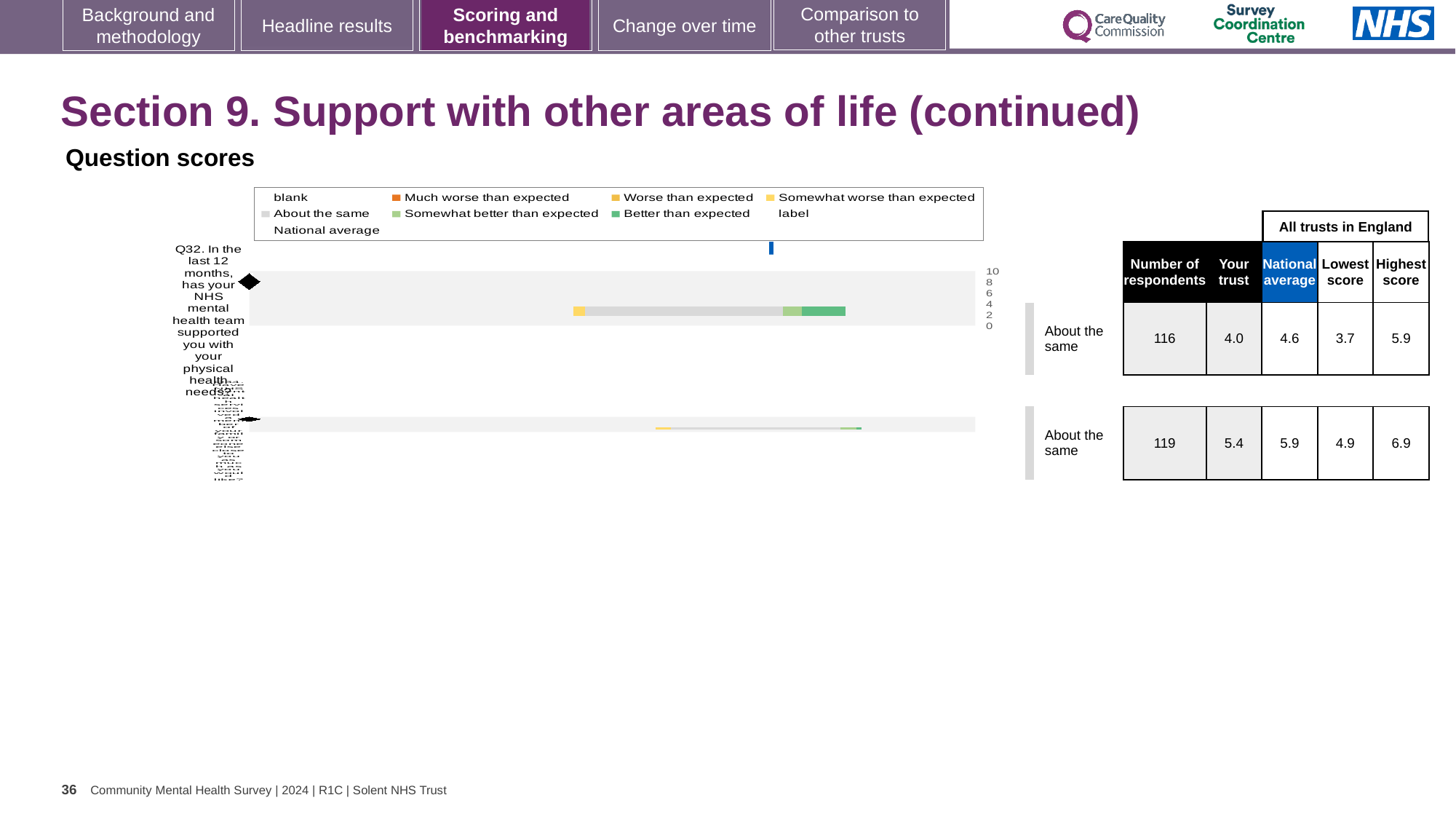
What is the highest score among all trusts in England for Q32? 5.9 How many questions are plotted in the chart? 2 What is the 'Your trust' score for Q32 (support with physical health needs)? 4.0 What kind of chart is shown on the slide? bar chart What is the lowest score among all trusts in England for Q32? 3.7 What is the difference between the national average and the trust's score for Q32? 0.6 What is the national average score for Q32? 4.6 How many respondents answered Q32? 116 What benchmark category is the trust's Q32 score placed in? About the same Which is larger for Q32: the trust's score or the national average? national average What is the difference between the highest and lowest scores for Q32? 2.2 Is the trust's score for Q32 greater or less than 6 on the chart axis? less